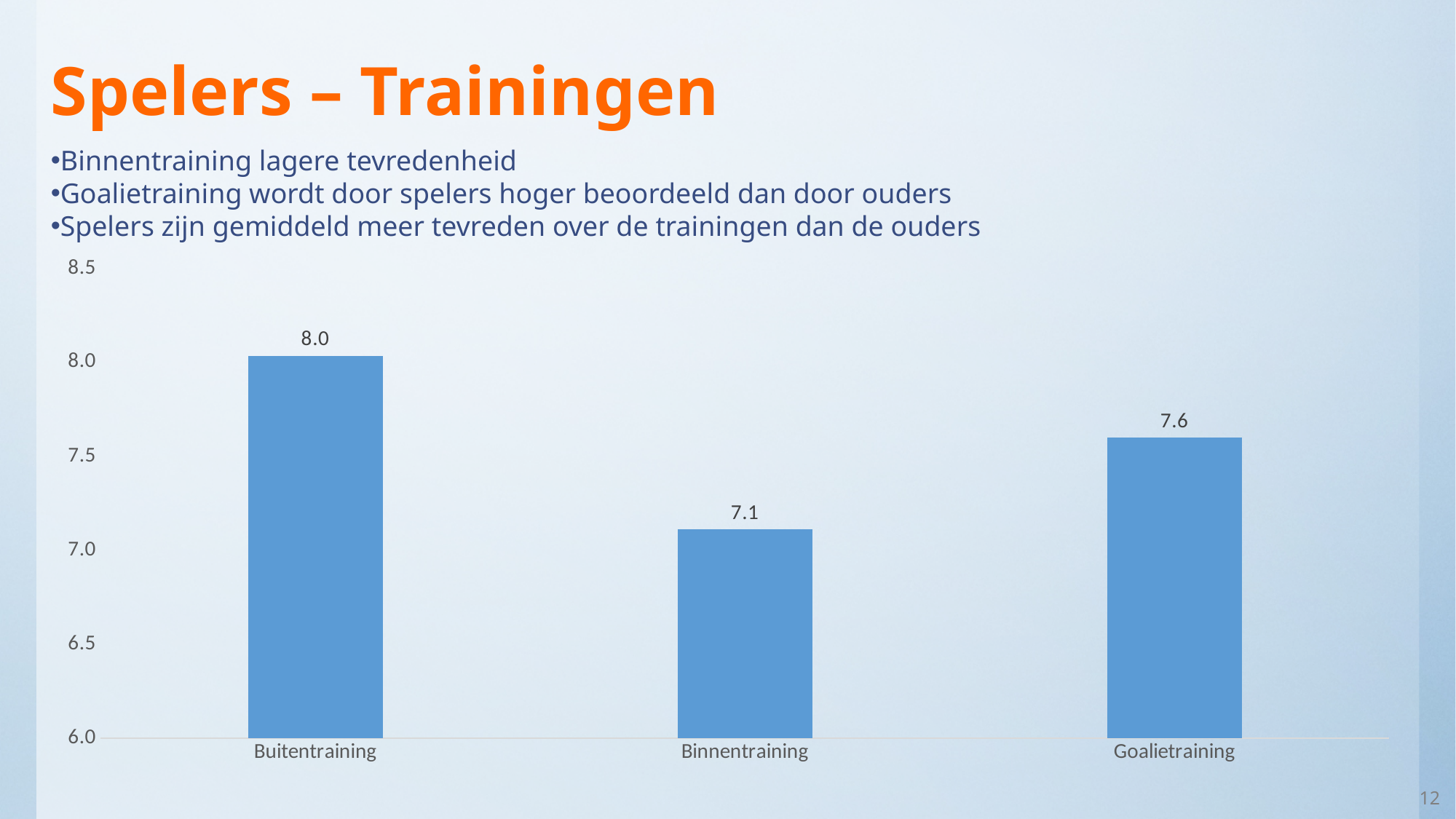
Which category has the lowest value? Binnentraining Is the value for Goalietraining greater or less than 7.5? greater What is the value for Buitentraining? 8.0 What is the value for Binnentraining? 7.1 What is the value for Goalietraining? 7.6 What is the difference between the values for Goalietraining and Binnentraining? 0.5 Which is larger, the value for Goalietraining or the value for Binnentraining? Goalietraining How many categories are shown in the chart? 3 What is the title of the slide containing the chart? Spelers – Trainingen Which category has the highest value? Buitentraining What is the difference between the values for Buitentraining and Binnentraining? 0.9 What kind of chart is shown on the slide? bar chart